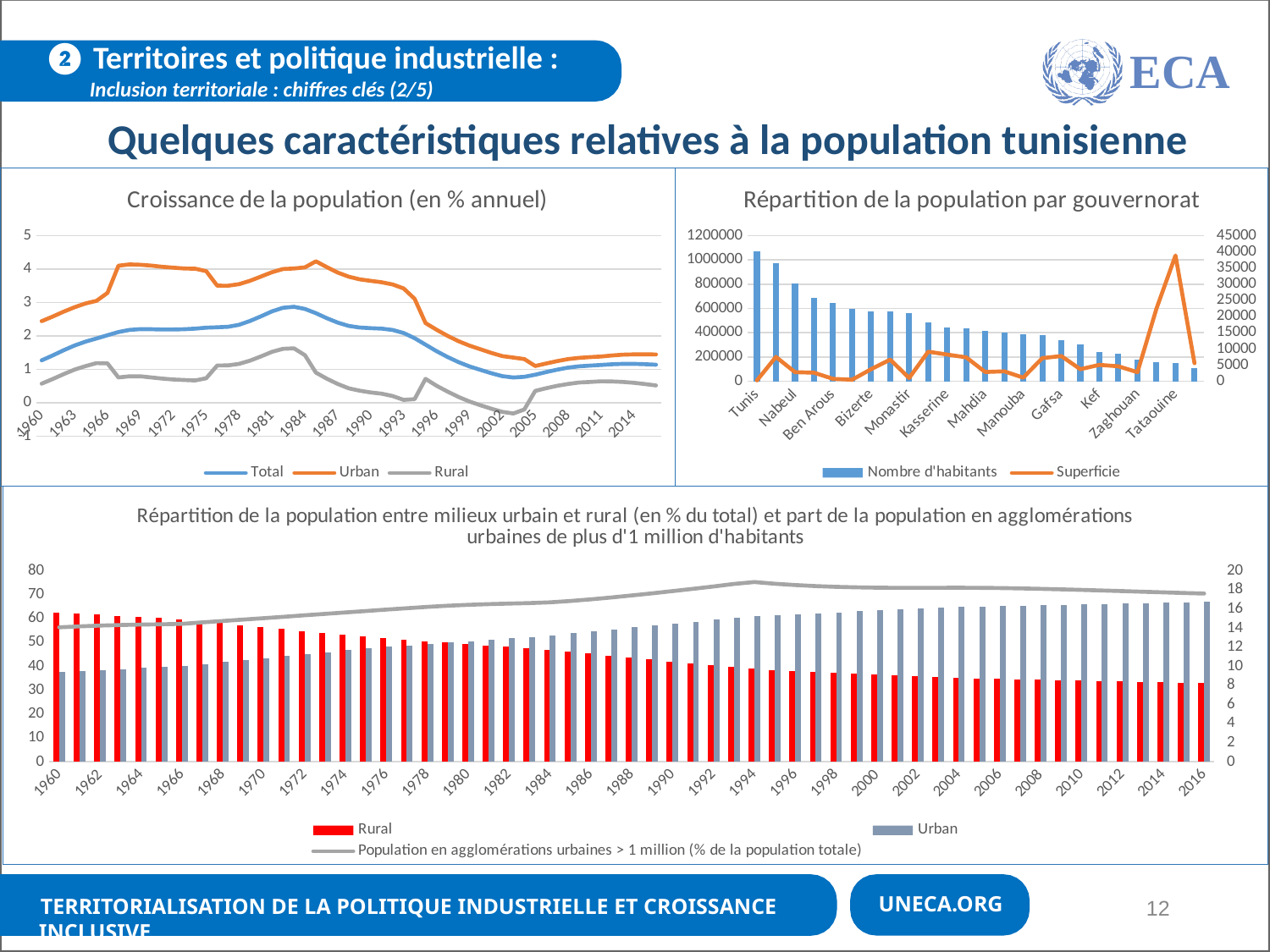
What type of chart is 'Croissance de la population (en % annuel)'? Line chart In the bottom chart, is the Urban value for 2016 greater or less than 60? greater In 'Croissance de la population (en % annuel)', is the Rural value for 1984 greater or less than 2? less How many series does the legend of 'Croissance de la population (en % annuel)' list? 3 In 'Croissance de la population (en % annuel)', is the Total value for 1984 greater or less than 2? greater In 'Croissance de la population (en % annuel)', which series has the highest values across the whole period? Urban In 'Répartition de la population par gouvernorat', which governorate has the highest Nombre d'habitants? Tunis How many series does the legend of 'Répartition de la population par gouvernorat' list? 2 In the bottom chart, does the Rural series rise or fall from 1960 to 2016? fall In 'Répartition de la population par gouvernorat', which governorate has the highest Superficie? Tataouine In 'Croissance de la population (en % annuel)', does the Total series rise or fall between 1984 and 2002? fall In the bottom chart, which is larger in 1960, Rural or Urban? Rural